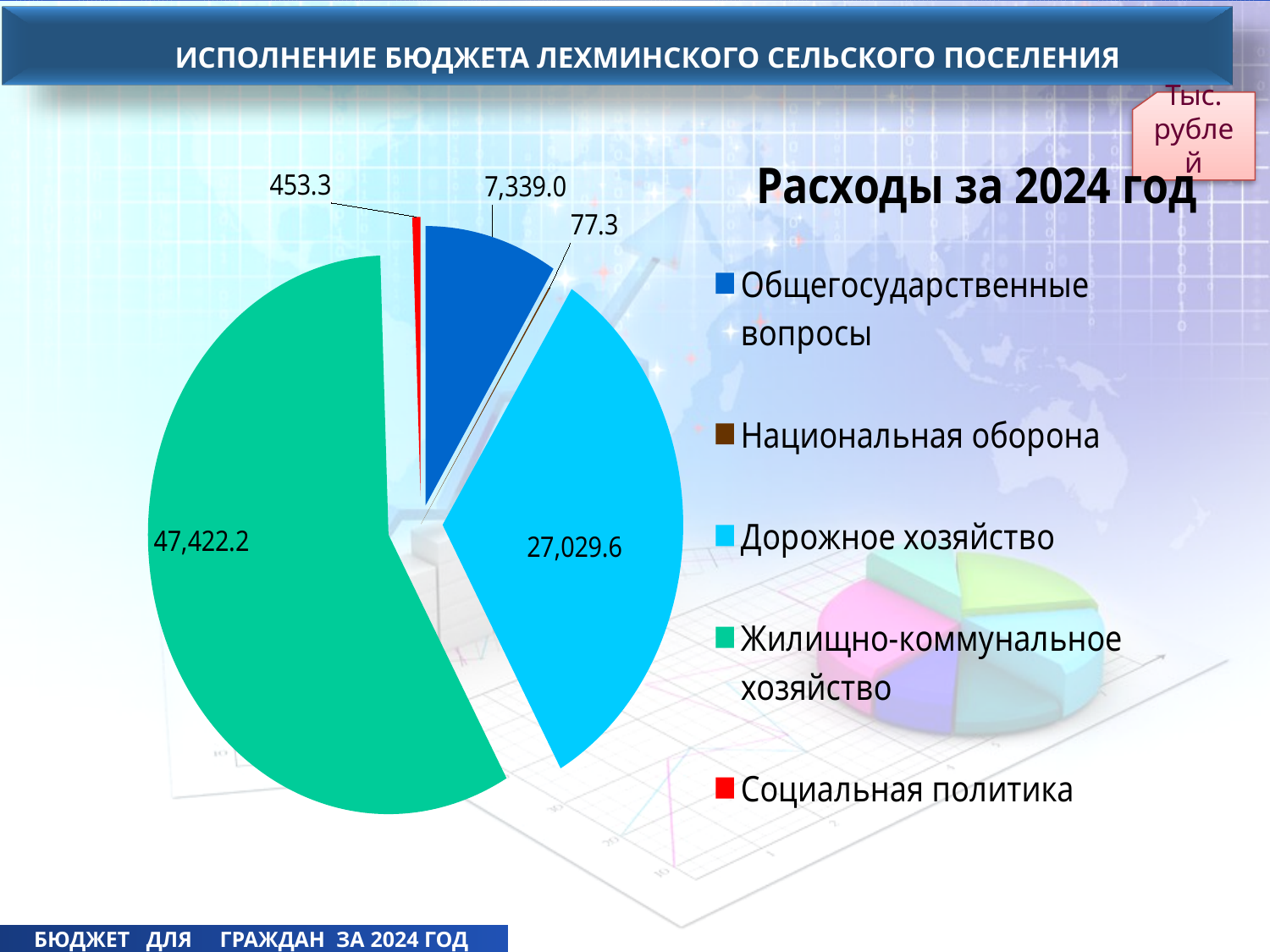
What is the value for Общегосударственные вопросы? 7,339.0 What is the value for Национальная оборона? 77.3 What kind of chart is shown on the slide? Pie chart What is the difference between Жилищно-коммунальное хозяйство and Дорожное хозяйство? 20,392.6 How many categories does the legend of the pie chart list? 5 What is the value for Социальная политика? 453.3 What is the value for Дорожное хозяйство? 27,029.6 Which category has the largest share of the pie? Жилищно-коммунальное хозяйство What is the title of the chart? Расходы за 2024 год Which category has the smallest value? Национальная оборона What is the value for Жилищно-коммунальное хозяйство? 47,422.2 Which is larger: Общегосударственные вопросы or Социальная политика? Общегосударственные вопросы